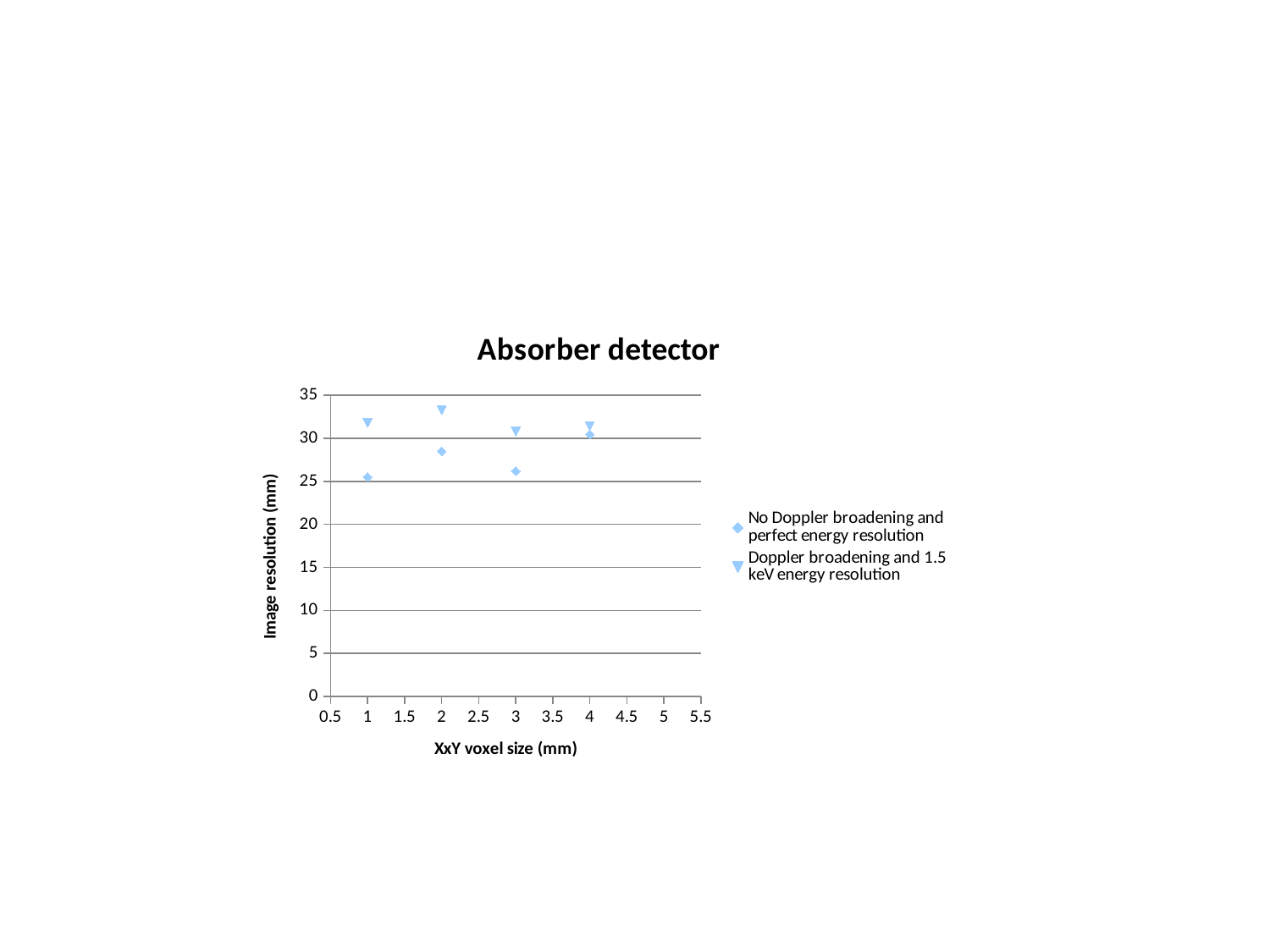
What kind of chart is shown on the slide? scatter chart Is the image resolution for 'Doppler broadening and 1.5 keV energy resolution' at a voxel size of 1 mm greater or less than 30? greater At which voxel size does the 'Doppler broadening and 1.5 keV energy resolution' series reach its highest image resolution value? 2 What is the label of the vertical axis? Image resolution (mm) How many series does the legend list? 2 Is the image resolution for 'Doppler broadening and 1.5 keV energy resolution' at a voxel size of 2 mm greater or less than 30? greater Is the image resolution for 'No Doppler broadening and perfect energy resolution' at a voxel size of 1 mm greater or less than 30? less How many data points are plotted for the 'No Doppler broadening and perfect energy resolution' series? 4 At which voxel size does the 'No Doppler broadening and perfect energy resolution' series reach its highest image resolution value? 4 At a voxel size of 1 mm, which series has the higher image resolution value? Doppler broadening and 1.5 keV energy resolution What is the title of the chart? Absorber detector